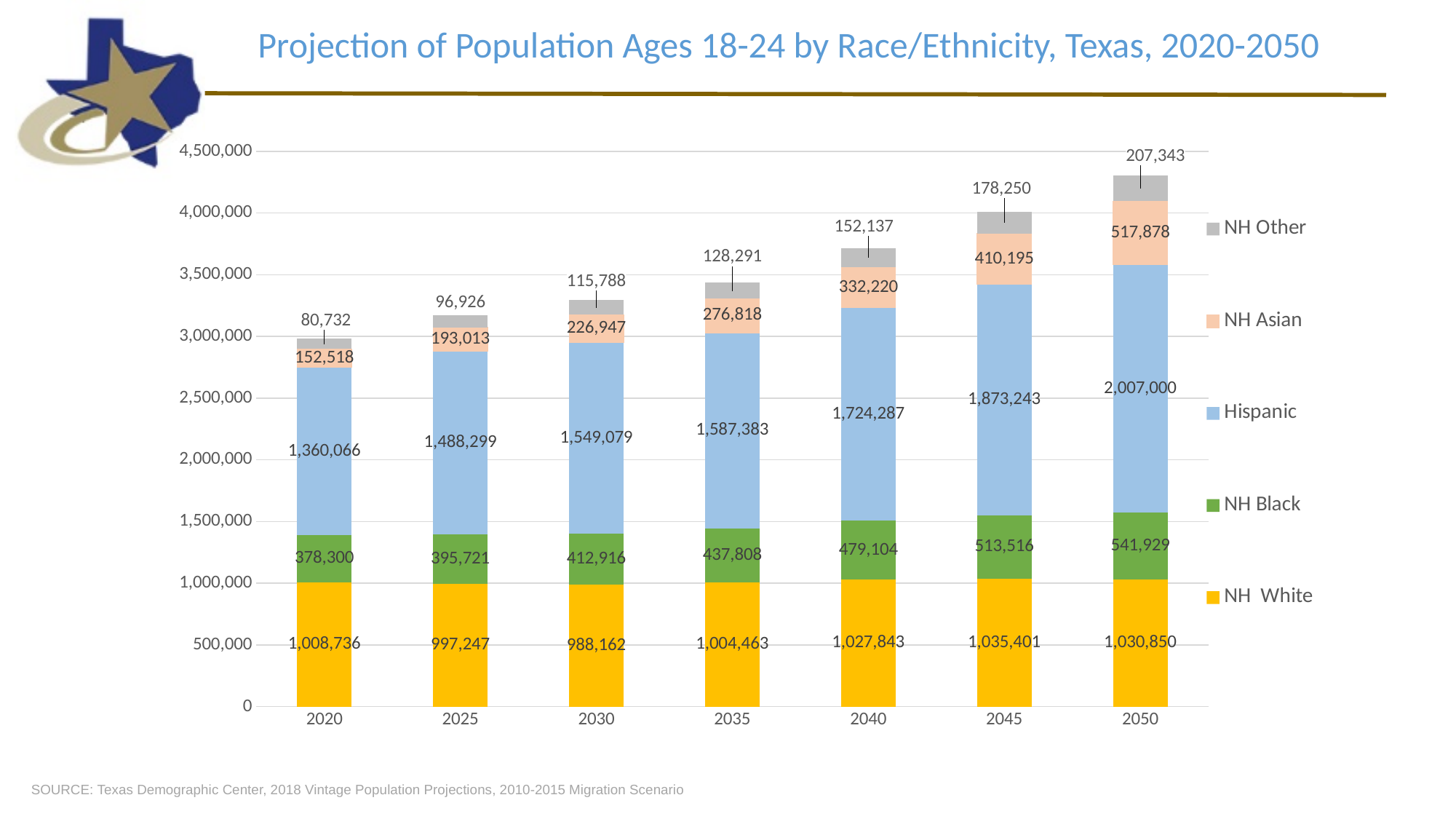
What is the NH Other value shown for 2020? 80,732 What is the projected Hispanic population ages 18-24 in Texas in 2030? 1,549,079 How many series does the legend list? 5 What is the total of the stacked bar for 2050? 4,305,000 In which year is the NH White value highest? 2045 How many years are shown on the x axis? 7 Does the Hispanic value rise or fall from 2020 to 2050? rise What is the difference between the NH Black values for 2045 and 2040? 34,412 By how much does the Hispanic value in 2050 exceed the Hispanic value in 2020? 646,934 What is the NH Asian value for 2045? 410,195 In which year is the NH White value lowest? 2030 Which is larger, the NH Asian value in 2035 or the NH Other value in 2050? NH Asian value in 2035